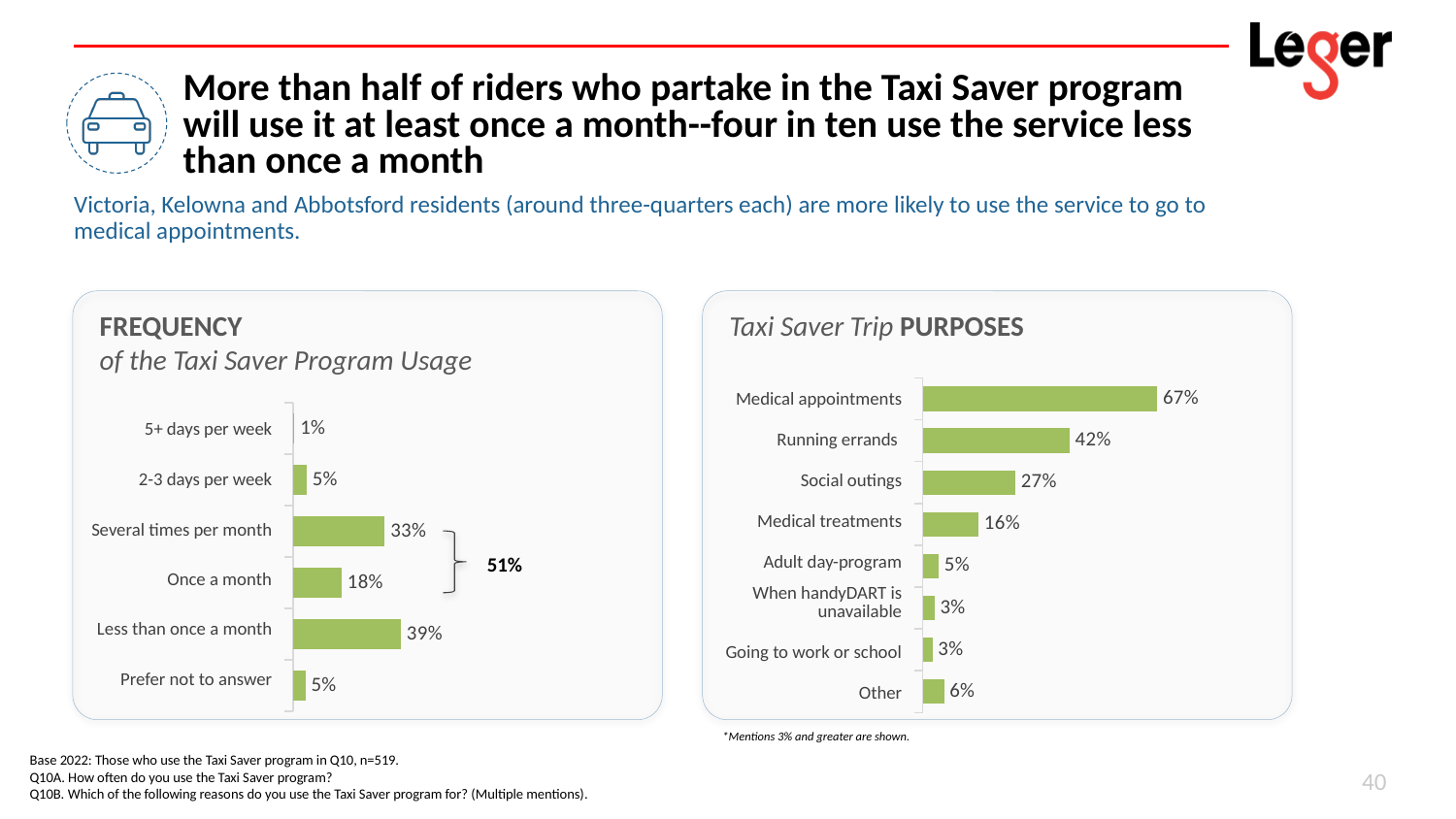
In the FREQUENCY of the Taxi Saver Program Usage chart, what is the value for Less than once a month? 39% In the Taxi Saver Trip PURPOSES chart, what is the value for Social outings? 27% In the FREQUENCY of the Taxi Saver Program Usage chart, what combined value is shown by the bracket grouping Several times per month and Once a month? 51% In the FREQUENCY of the Taxi Saver Program Usage chart, what is the value for Several times per month? 33% In the FREQUENCY of the Taxi Saver Program Usage chart, which category has the highest value? Less than once a month In the Taxi Saver Trip PURPOSES chart, what is the value for Medical appointments? 67% In the Taxi Saver Trip PURPOSES chart, which is larger: Running errands or Medical treatments? Running errands In the FREQUENCY of the Taxi Saver Program Usage chart, which category has the lowest value? 5+ days per week In the FREQUENCY of the Taxi Saver Program Usage chart, what is the difference between Several times per month and Once a month? 15% In the Taxi Saver Trip PURPOSES chart, which purpose has the highest value? Medical appointments What kind of chart is the Taxi Saver Trip PURPOSES chart? Bar chart In the FREQUENCY of the Taxi Saver Program Usage chart, how many categories are shown? 6